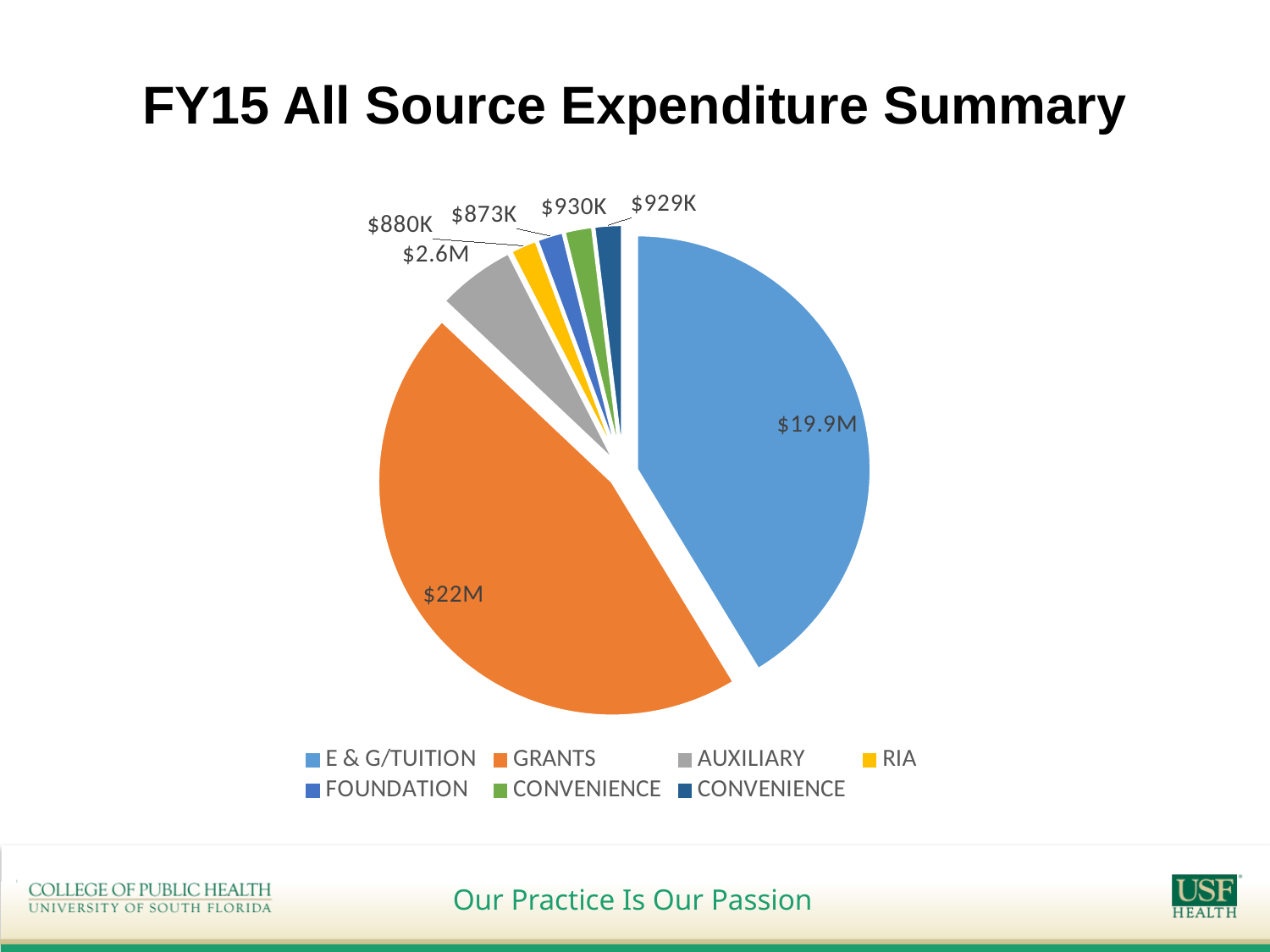
Which is larger, GRANTS or E & G/TUITION? GRANTS What is the value shown for FOUNDATION? $873K What is the value shown for RIA? $880K How many slices does the pie chart have? 7 What is the value shown for E & G/TUITION? $19.9M Which is larger, AUXILIARY or RIA? AUXILIARY What is the difference between the GRANTS value and the E & G/TUITION value? $2.1M What is the value shown for GRANTS? $22M What is the value shown for AUXILIARY? $2.6M What kind of chart is shown on the slide? pie chart Which category has the largest slice of the pie? GRANTS What is the title of the chart? FY15 All Source Expenditure Summary